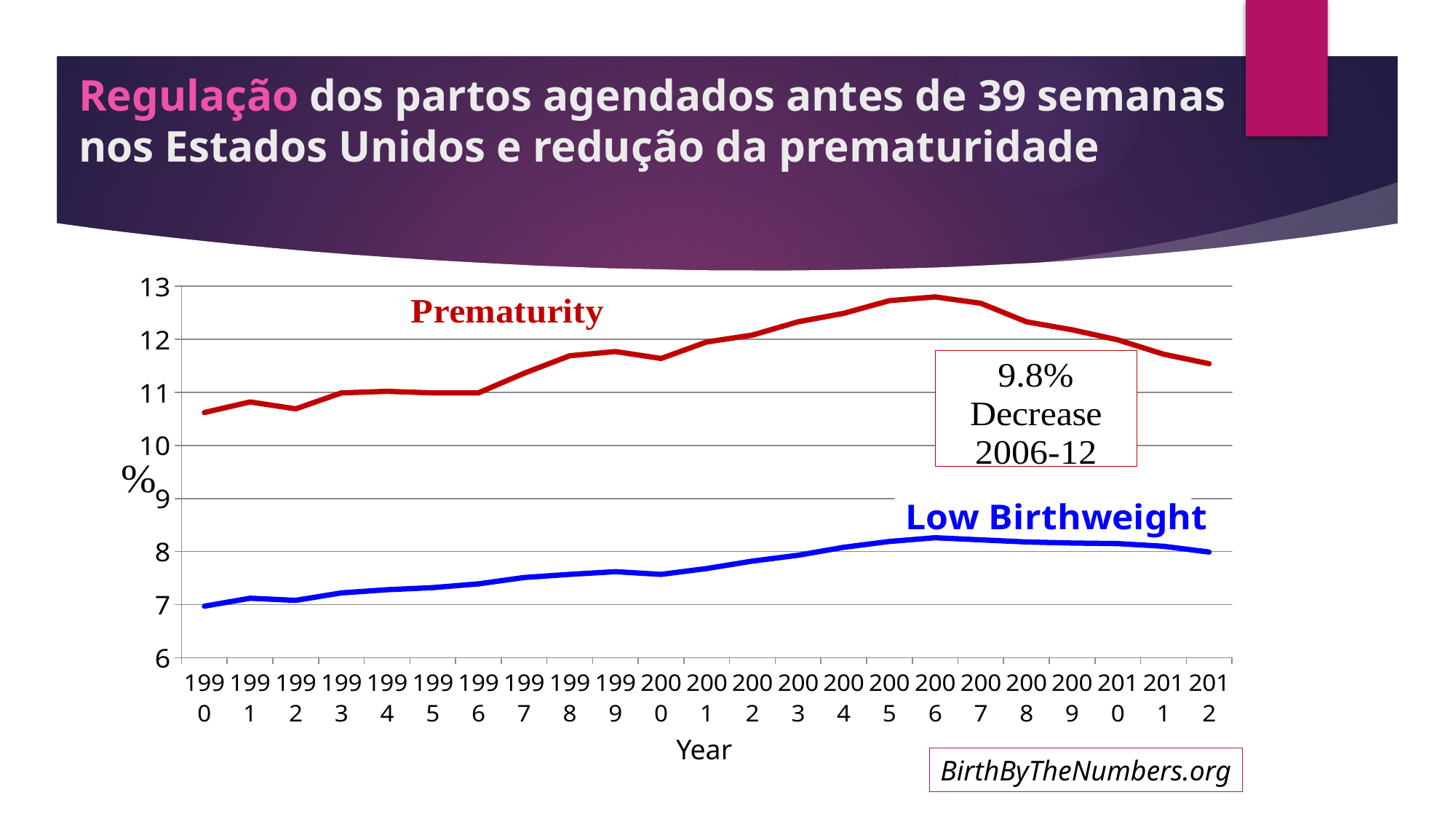
Is the Prematurity value for 2012 greater or less than 11? greater In 2006, which series has the larger value, Prematurity or Low Birthweight? Prematurity How many series are plotted on the chart? 2 In which year does the Prematurity line reach its highest value? 2006 Is the Prematurity value for 2000 greater or less than 12? less What kind of chart is shown on the slide? line chart What decrease does the text box on the chart report for 2006-12? 9.8% Is the Prematurity value for 2006 greater or less than 12? greater How many years are shown along the x axis of the chart? 23 Does the Prematurity line rise or fall from 2006 to 2012? fall